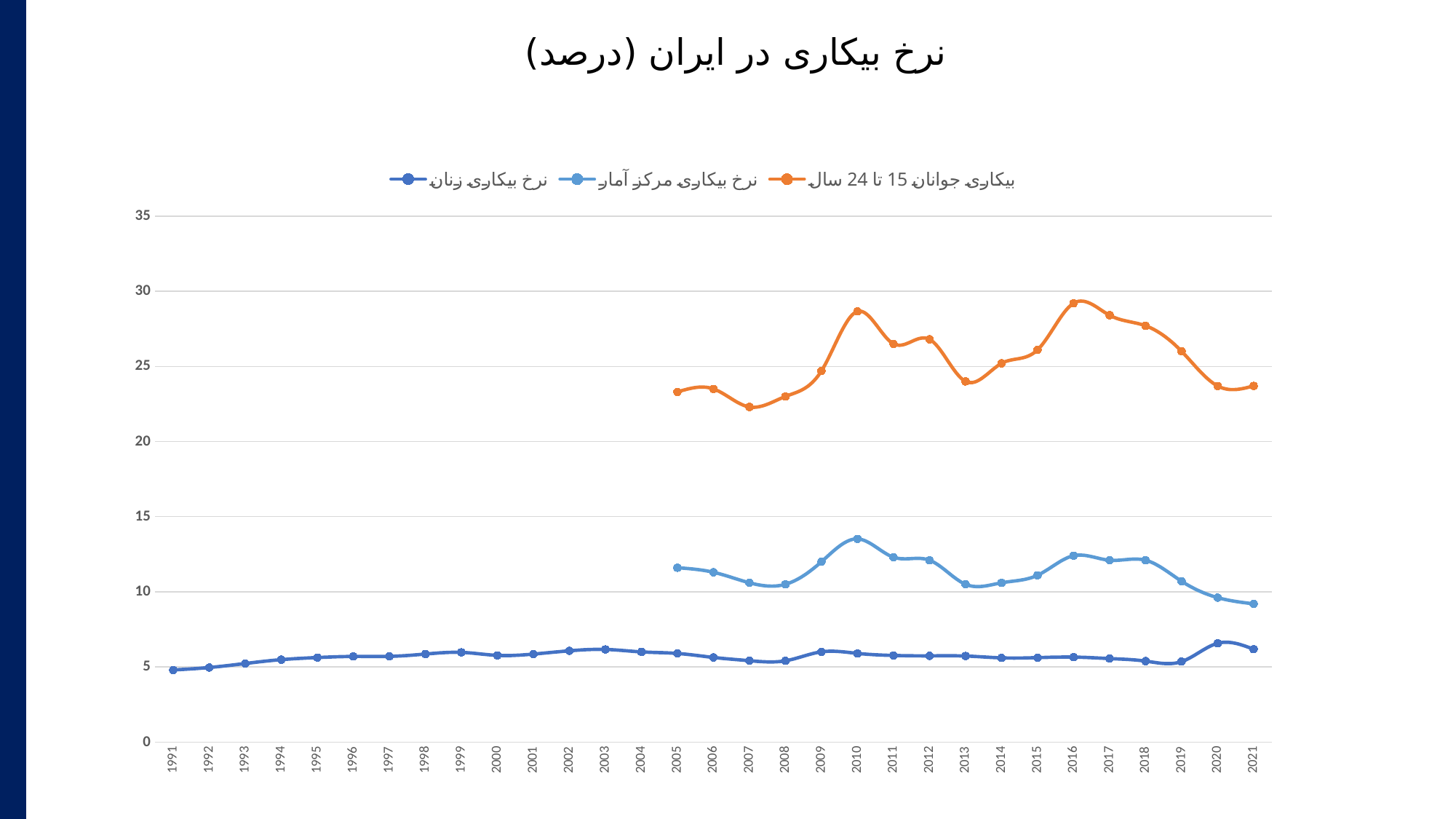
In 2010, which series has the larger value: بیکاری جوانان 15 تا 24 سال or نرخ بیکاری مرکز آمار? بیکاری جوانان 15 تا 24 سال Which series is drawn in orange? بیکاری جوانان 15 تا 24 سال How many years are shown on the x axis? 31 Between 2016 and 2020, does the series بیکاری جوانان 15 تا 24 سال rise or fall? fall Is the value for بیکاری جوانان 15 تا 24 سال in 2010 greater or less than 25? greater Is the value for نرخ بیکاری مرکز آمار in 2021 greater or less than 10? less In which year does the series بیکاری جوانان 15 تا 24 سال reach its highest value? 2016 In which year does the series نرخ بیکاری مرکز آمار reach its highest value? 2010 What is the title of the chart? نرخ بیکاری در ایران (درصد) How many series does the legend list? 3 What kind of chart is shown on the slide? line chart